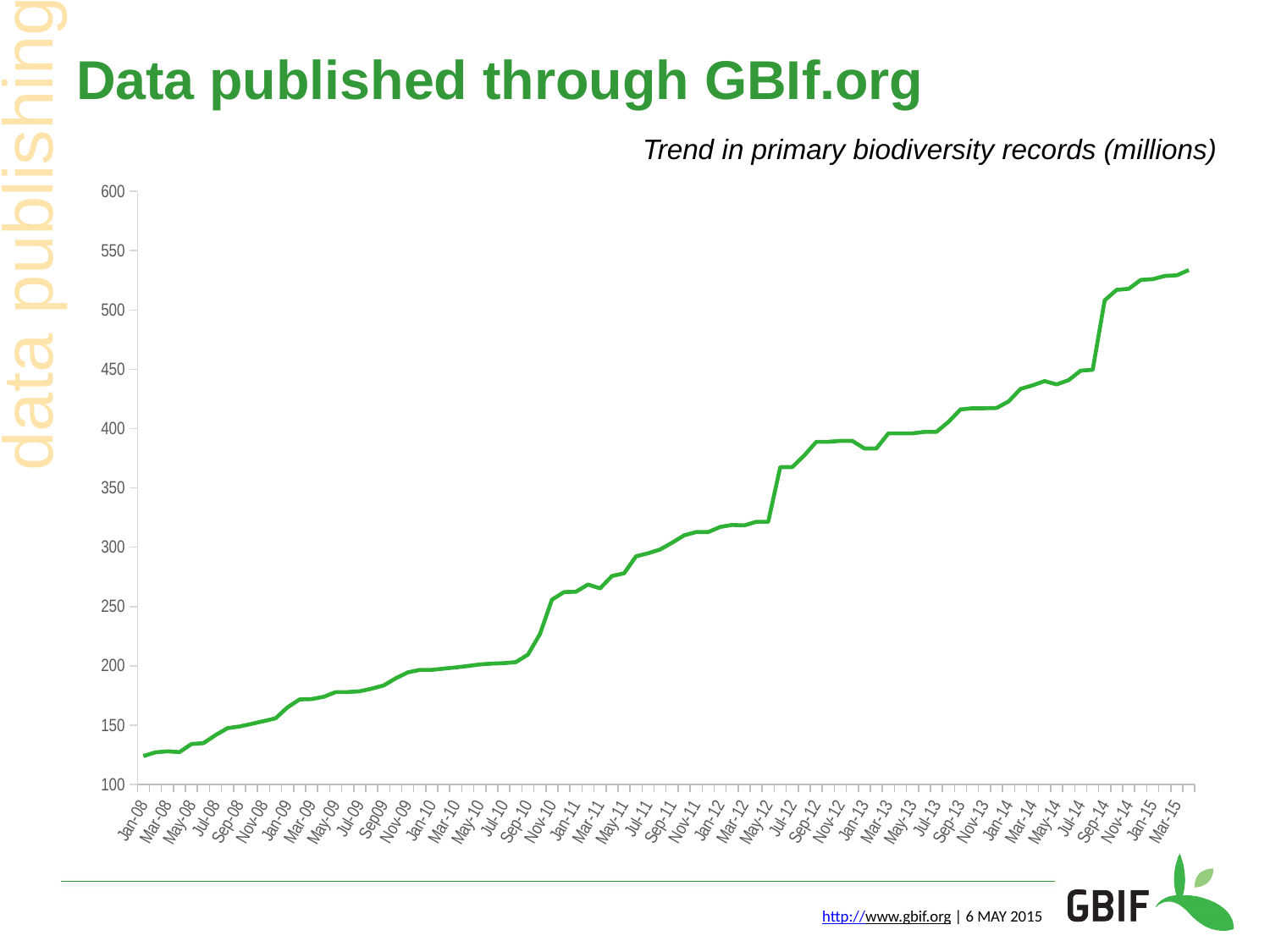
What colour is the plotted line? green What is the subtitle shown above the chart? Trend in primary biodiversity records (millions) Which is larger, the value for Sep-14 or the value for Jul-14? Sep-14 Is the value for Jan-08 greater or less than 150? less Do the values rise or fall along the x axis from Jan-08 to Mar-15? rise Is the value for Mar-15 greater or less than 500? greater What kind of chart is shown on the slide? line chart Is the value for Jul-12 greater or less than 350? greater At which x-axis label is the plotted value lowest? Jan-08